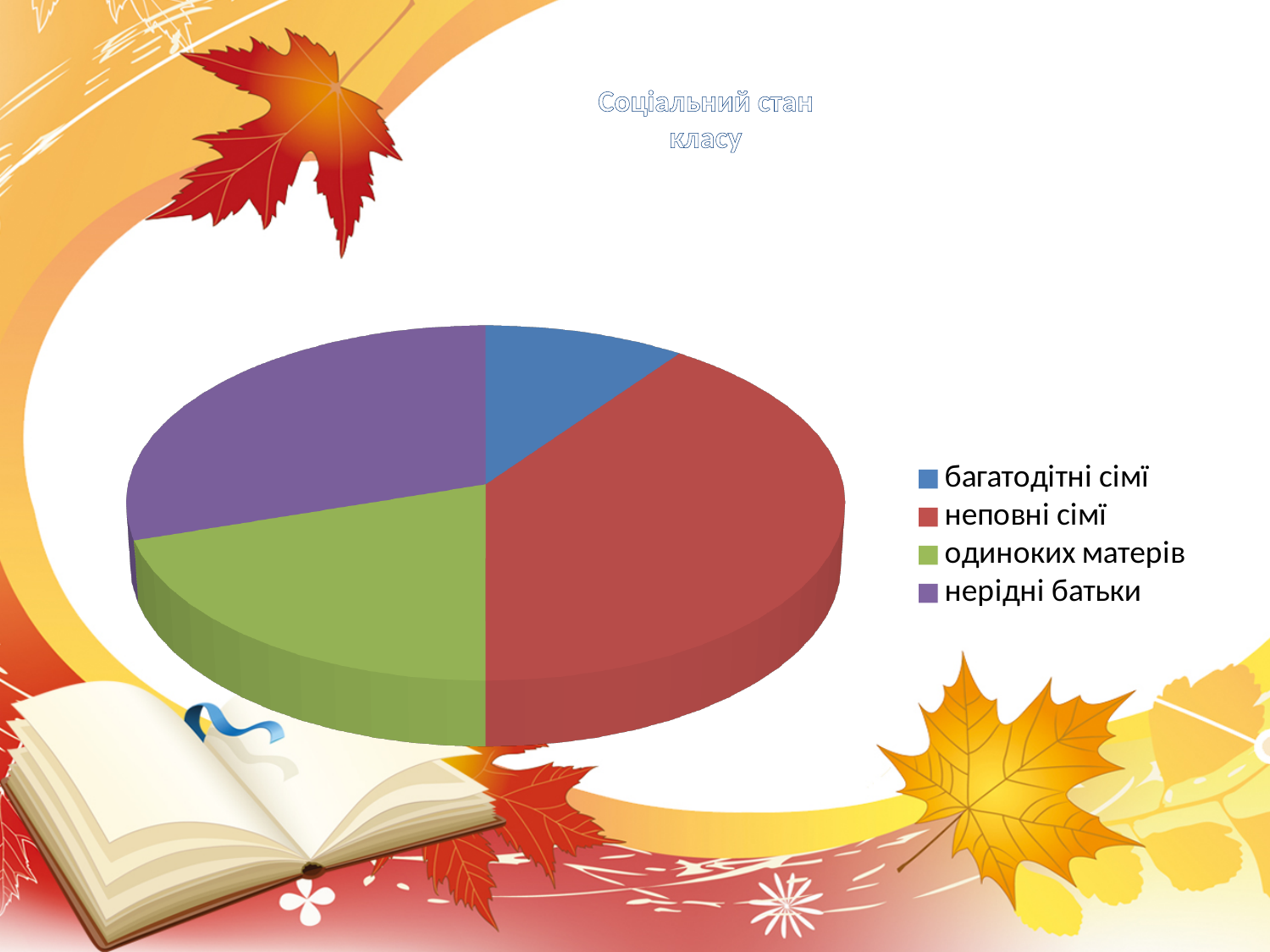
Which slice is larger: неповні сімї or одиноких матерів? неповні сімї Which category has the largest slice of the pie chart? неповні сімї Which slice is larger: одиноких матерів or багатодітні сімї? одиноких матерів What kind of chart is shown on the slide? pie chart How many entries does the legend of the pie chart list? 4 What is the title of the pie chart? Соціальний стан класу Which slice is larger: нерідні батьки or багатодітні сімї? нерідні батьки How many categories does the pie chart show? 4 Which category has the smallest slice of the pie chart? багатодітні сімї What colour is the slice for неповні сімї in the pie chart? red